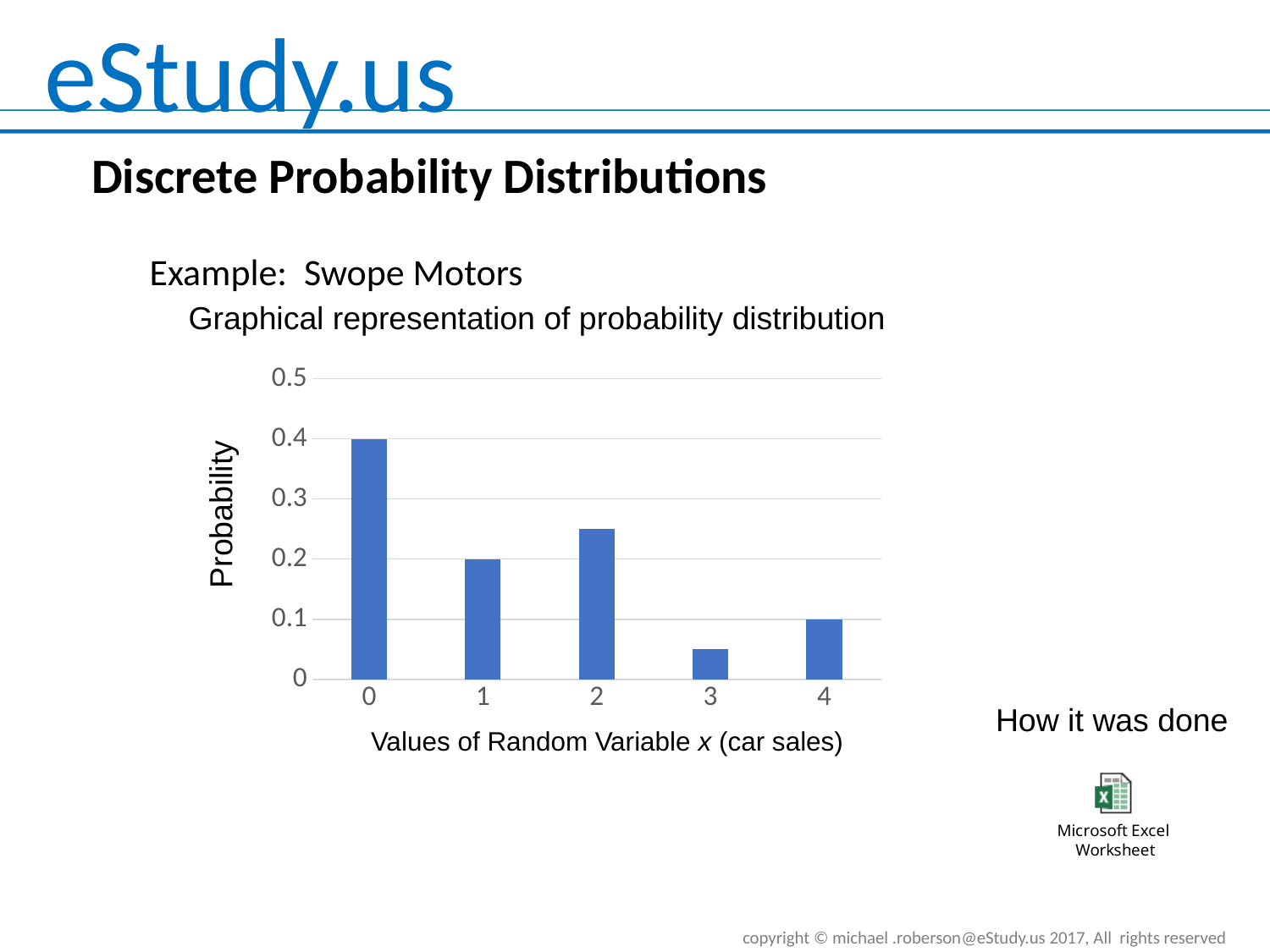
What is the label of the vertical axis? Probability Which value of x has the lowest probability? 3 What is the probability for x = 1? 0.2 Which has a larger probability, x = 2 or x = 4? x = 2 What is the probability for x = 4? 0.1 What type of chart is shown on the slide? bar chart What is the difference between the probabilities for x = 0 and x = 1? 0.2 Is the probability for x = 3 greater or less than 0.1? less Is the probability for x = 2 greater or less than 0.2? greater What is the probability for x = 0? 0.4 Which value of x has the highest probability? 0 How many values of the random variable x are plotted? 5